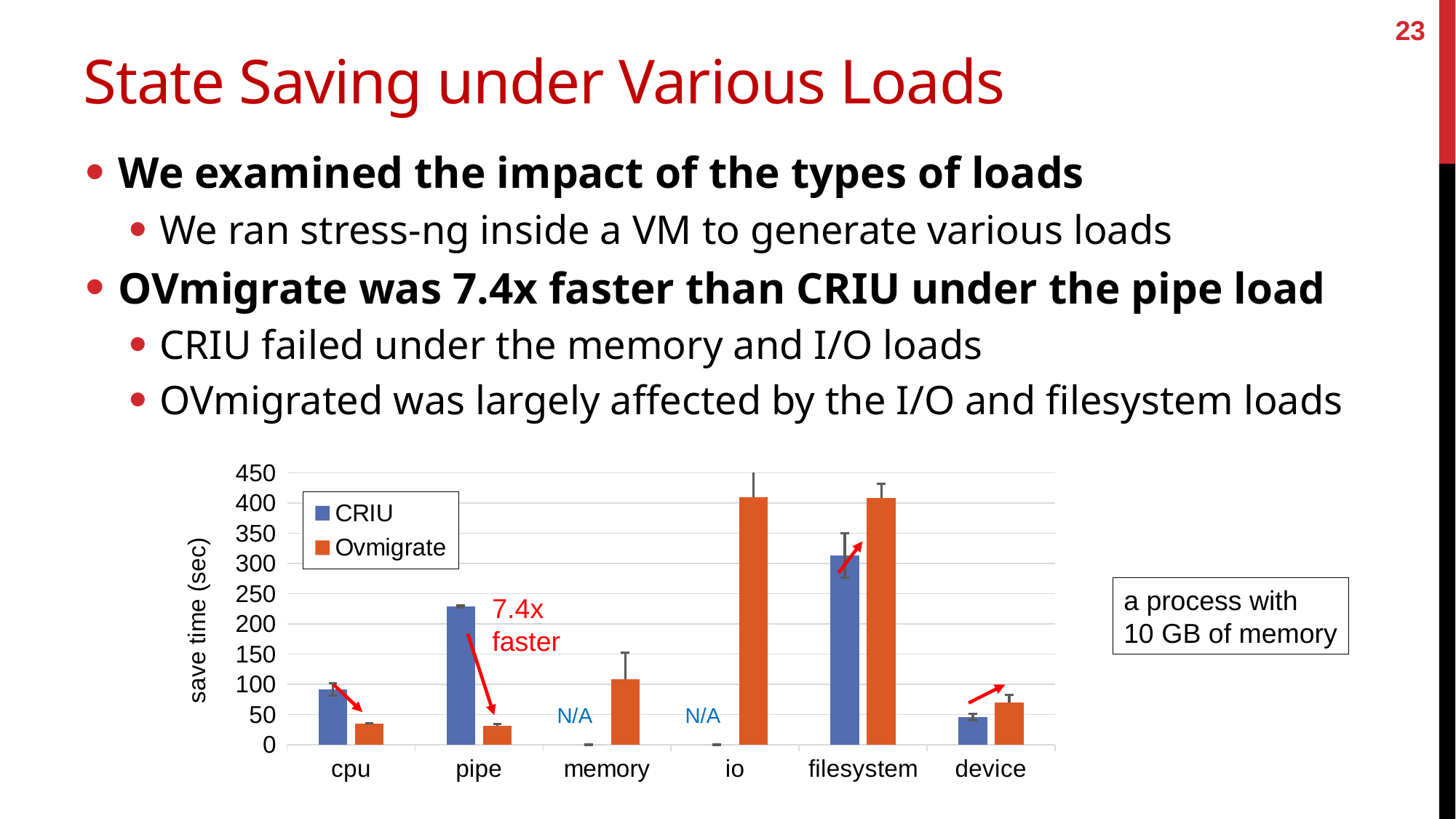
Under the filesystem load, which has the larger save time, CRIU or Ovmigrate? Ovmigrate Under the pipe load, which has the larger save time, CRIU or Ovmigrate? CRIU Is the Ovmigrate save time for the memory load greater or less than 150? less What is the label of the y axis of the chart? save time (sec) How many load categories are shown on the x axis of the chart? 6 Is the Ovmigrate save time for the io load greater or less than 350? greater How many series does the chart legend list? 2 Which series are listed in the chart legend? CRIU and Ovmigrate For which load does CRIU have the lowest save time among the loads where it has a bar? device Is the CRIU save time for the pipe load greater or less than 200? greater For which load does CRIU have the highest save time? filesystem What kind of chart is shown on the slide? bar chart